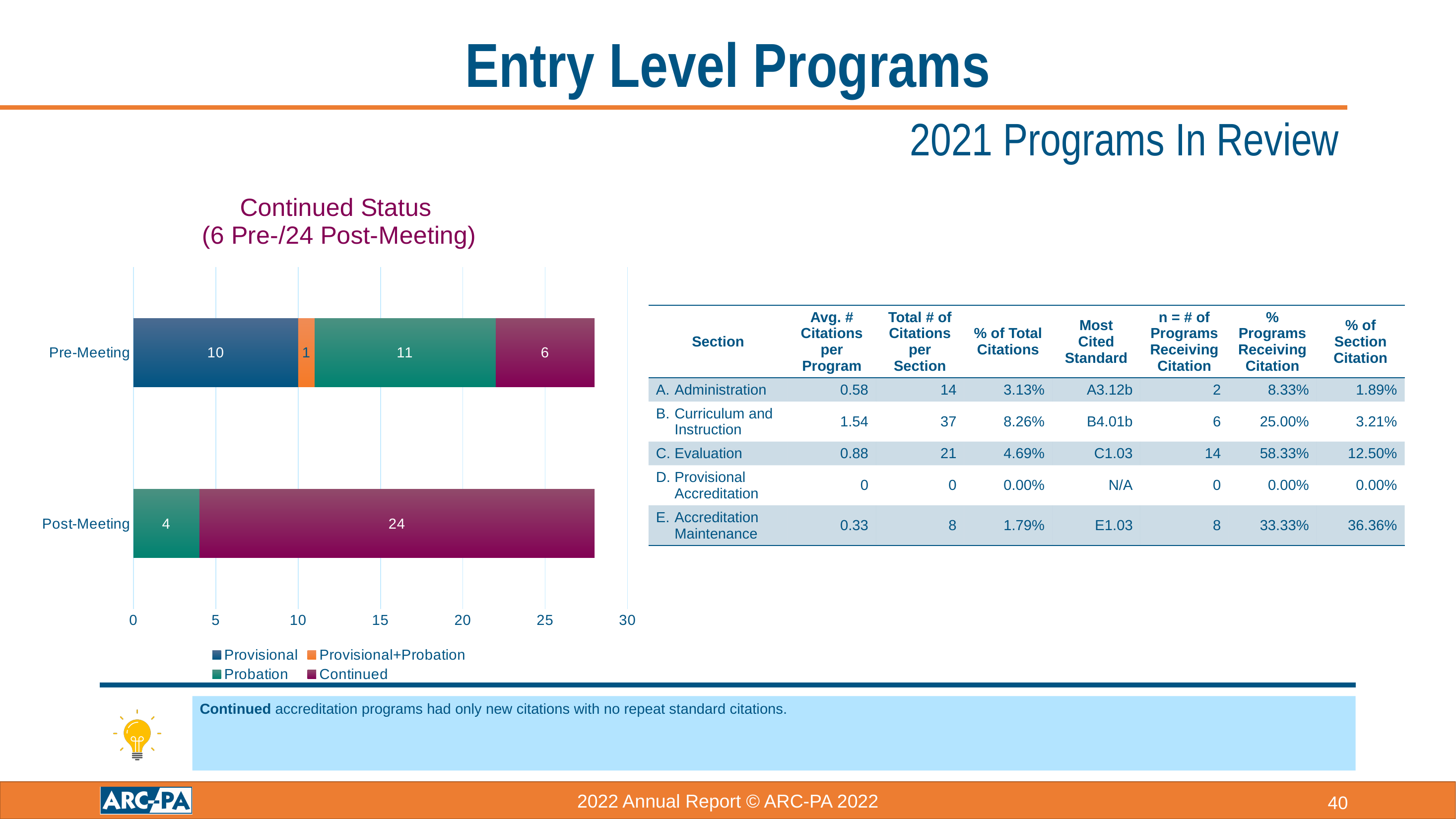
What is the Continued value for Post-Meeting? 24 How many series does the chart legend list? 4 What is the total of the Pre-Meeting stacked bar? 28 What is the Probation value for Pre-Meeting? 11 What kind of chart is shown on the slide? Stacked bar chart What is the Provisional+Probation value for Pre-Meeting? 1 What is the Probation value for Post-Meeting? 4 Which is larger, the Probation value for Pre-Meeting or for Post-Meeting? Pre-Meeting What is the Provisional value for Pre-Meeting? 10 How many categories are plotted on the chart? 2 What is the difference between the Continued values for Post-Meeting and Pre-Meeting? 18 What is the title of the chart? Continued Status (6 Pre-/24 Post-Meeting)